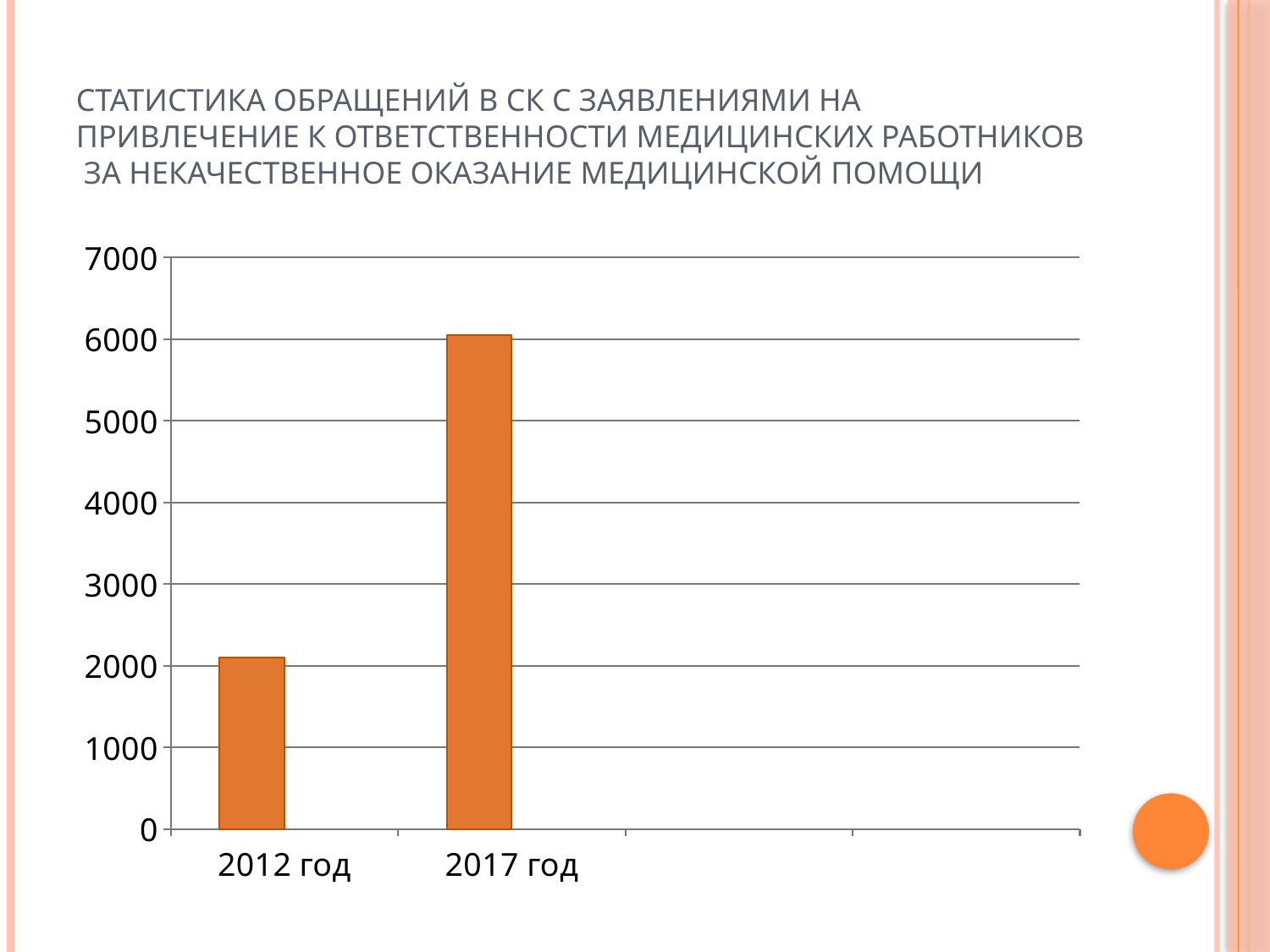
Do the values rise or fall from 2012 год to 2017 год? rise Which category has the highest value on the chart? 2017 год Which is larger, the value for 2012 год or the value for 2017 год? 2017 год What is the highest value shown on the vertical axis? 7000 Is the value for 2017 год greater or less than 7000? less Is the value for 2012 год greater or less than 1000? greater What colour are the bars on the chart? orange Is the value for 2012 год greater or less than 3000? less Which category has the lowest value on the chart? 2012 год What kind of chart is shown on the slide? bar chart How many categories (bars) are plotted on the chart? 2